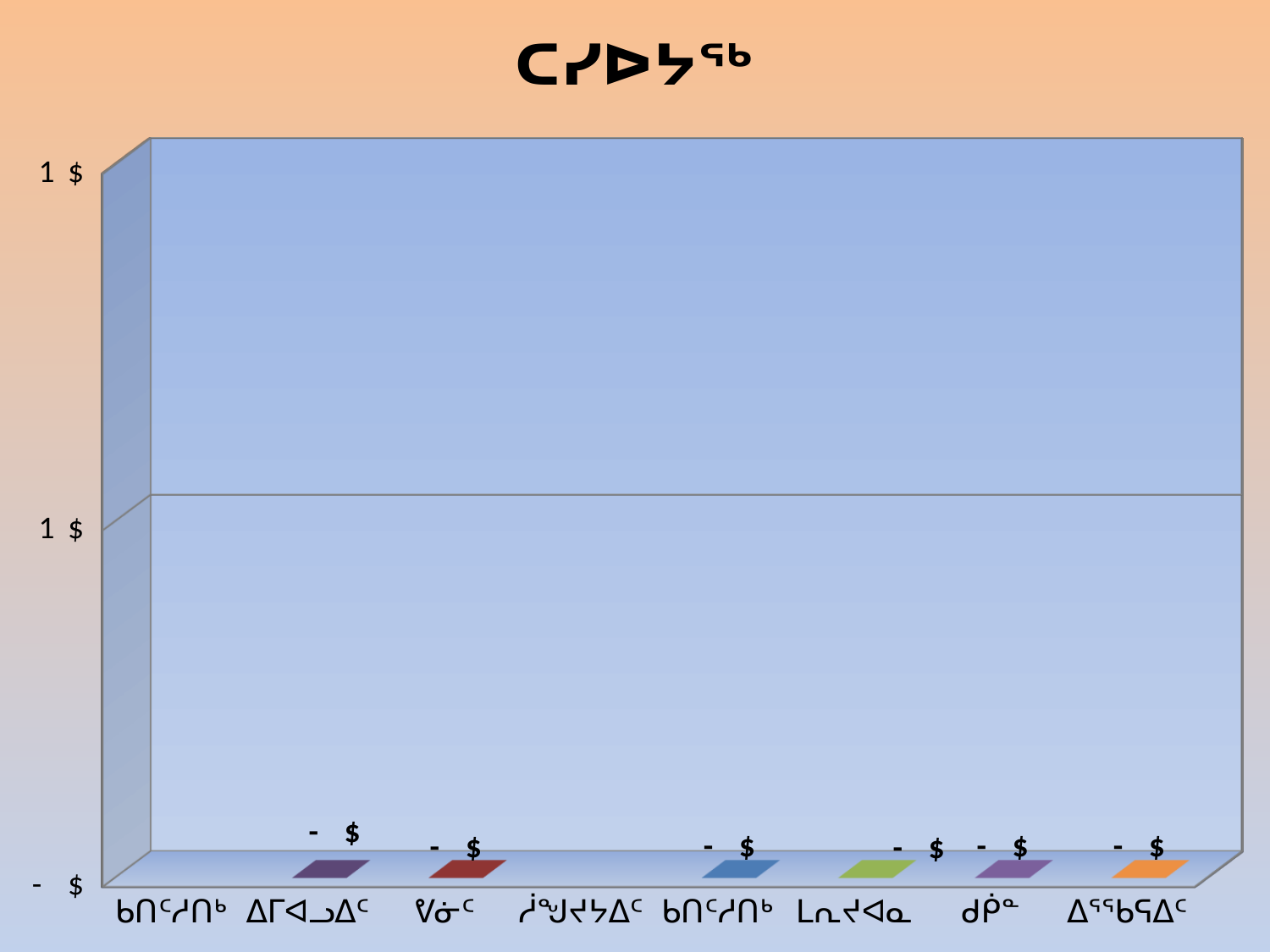
What value label is printed above the third bar from the left? - $ How many bars have a data label printed above them? 6 What is the label of the lowest tick on the vertical axis? - $ What value label is printed above the rightmost bar? - $ What value label is printed above the second bar from the left? - $ Is the value for the rightmost category greater or less than 1 $? less What kind of chart is shown on the slide? bar chart What is the label of the topmost tick on the vertical axis? 1 $ How many categories are listed along the x axis of the chart? 8